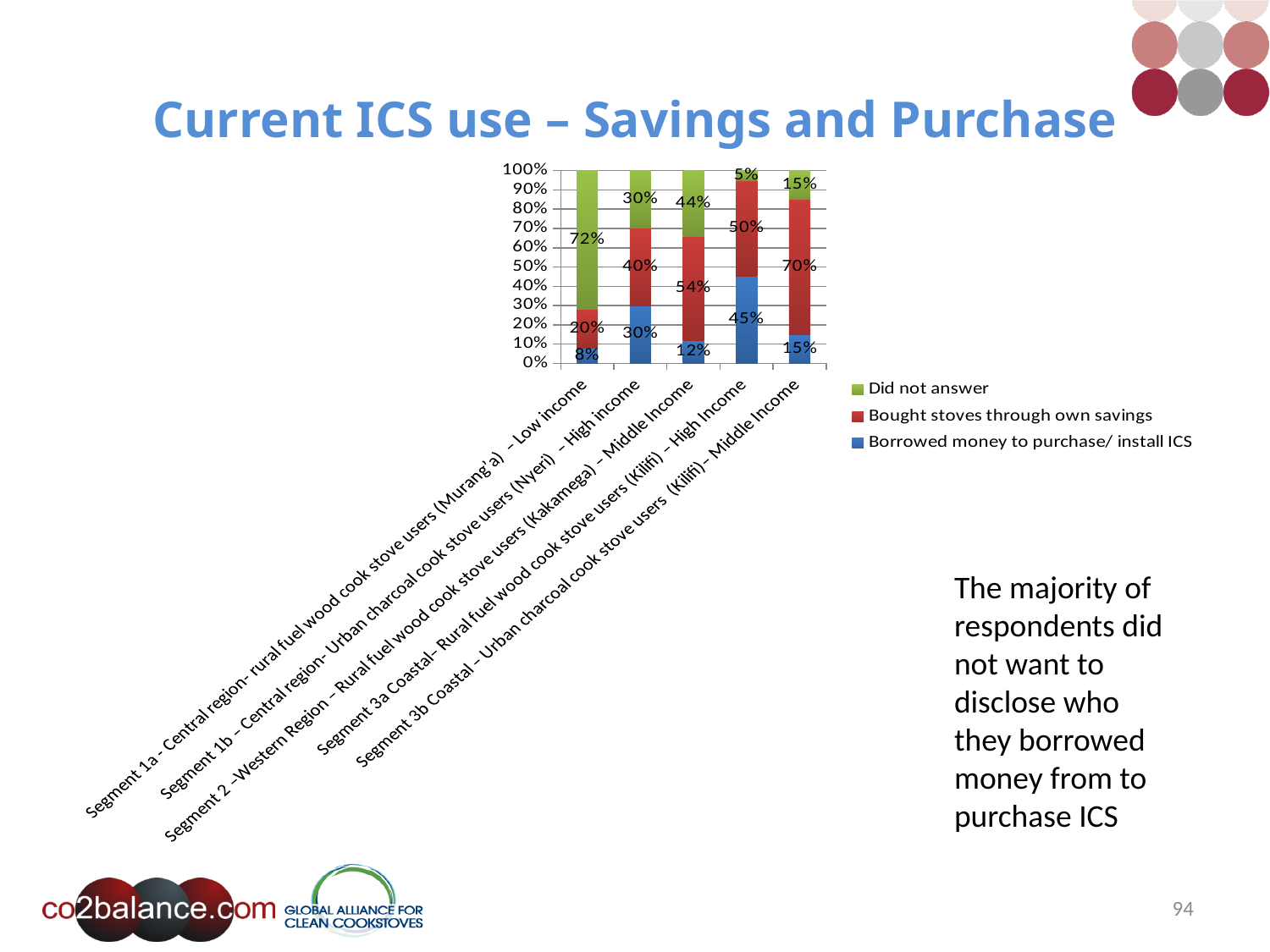
What percentage of Segment 1a (Murang'a, Low income) respondents did not answer? 72% How many series does the legend list? 3 Which colour represents 'Did not answer' in the chart? Green Which segment has the highest share of respondents who did not answer? Segment 1a - Central region- rural fuel wood cook stove users (Murang'a) - Low income What percentage of Segment 3a (Kilifi, High Income) respondents borrowed money to purchase/install ICS? 45% What kind of chart is shown on the slide? Stacked bar chart Which segment has the lowest share of respondents who did not answer? Segment 3a Coastal- Rural fuel wood cook stove users (Kilifi) - High Income What percentage of Segment 3b (Kilifi, Middle Income) respondents bought stoves through own savings? 70% How many segments (categories) are plotted on the x axis? 5 Which segment has a larger 'Borrowed money to purchase/ install ICS' share: Segment 1b (Nyeri, High income) or Segment 3b (Kilifi, Middle Income)? Segment 1b - Central region- Urban charcoal cook stove users (Nyeri) - High income What percentage of Segment 2 (Kakamega, Middle Income) respondents borrowed money to purchase/install ICS? 12% What is the difference between the 'Bought stoves through own savings' share for Segment 3b (Kilifi, Middle Income) and Segment 1a (Murang'a, Low income)? 50%